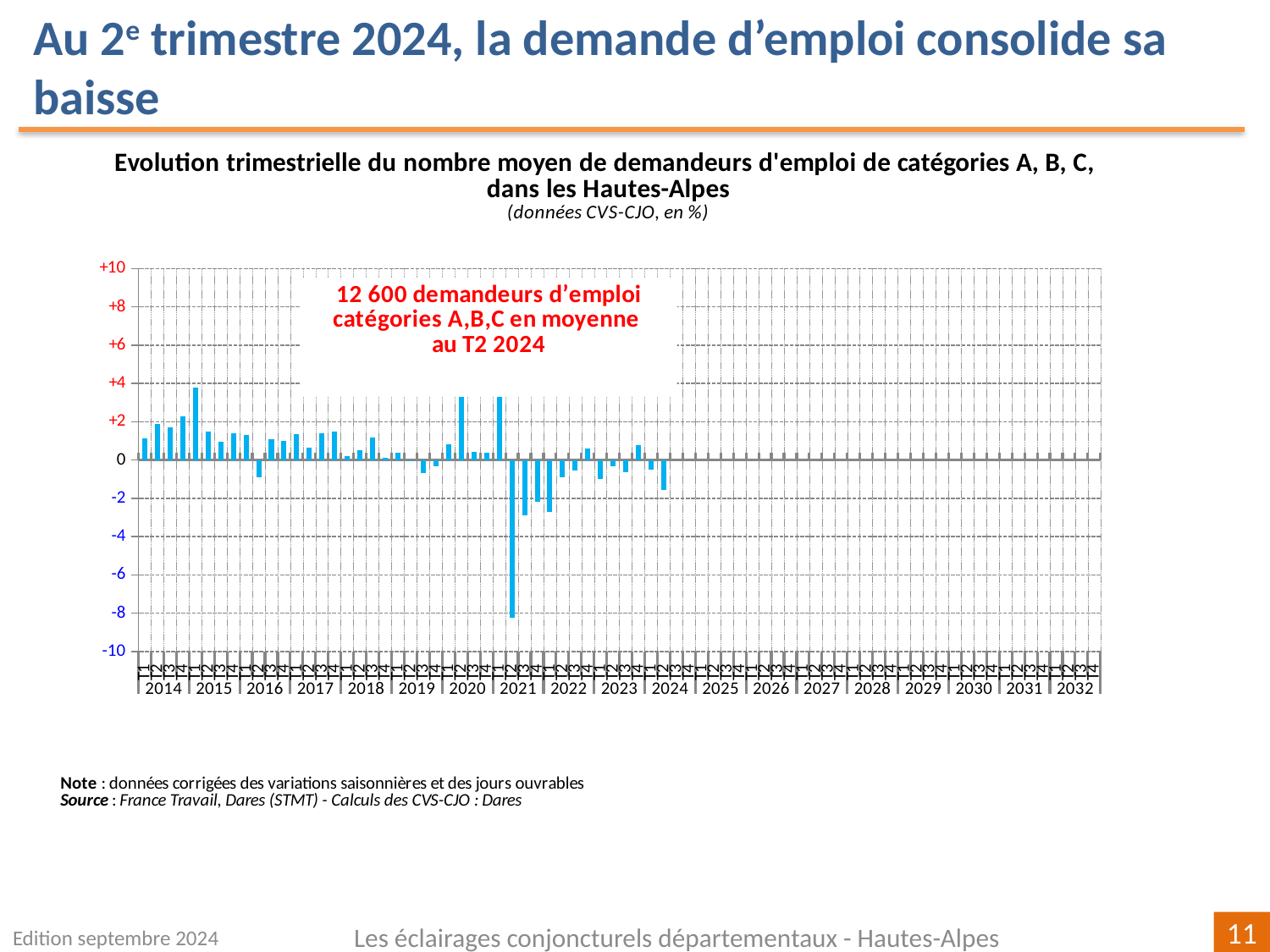
According to the annotation on the chart, how many demandeurs d'emploi catégories A,B,C were there on average at T2 2024? 12 600 Are the bars for T2, T3 and T4 of 2021 above or below zero? below Which quarter has the lowest value on the chart? T2 2021 Is the value for T2 2021 greater or less than -6? less Is the value for T4 2014 greater or less than +2? greater Is the value for T2 2024 greater or less than 0? less Which is larger, the value for T1 2020 or the value for T2 2020? T2 2020 What kind of chart is shown on the slide? bar chart Which is larger, the value for T4 2014 or the value for T2 2021? T4 2014 What is the highest value shown on the y axis? +10 How many years are labelled along the x axis? 19